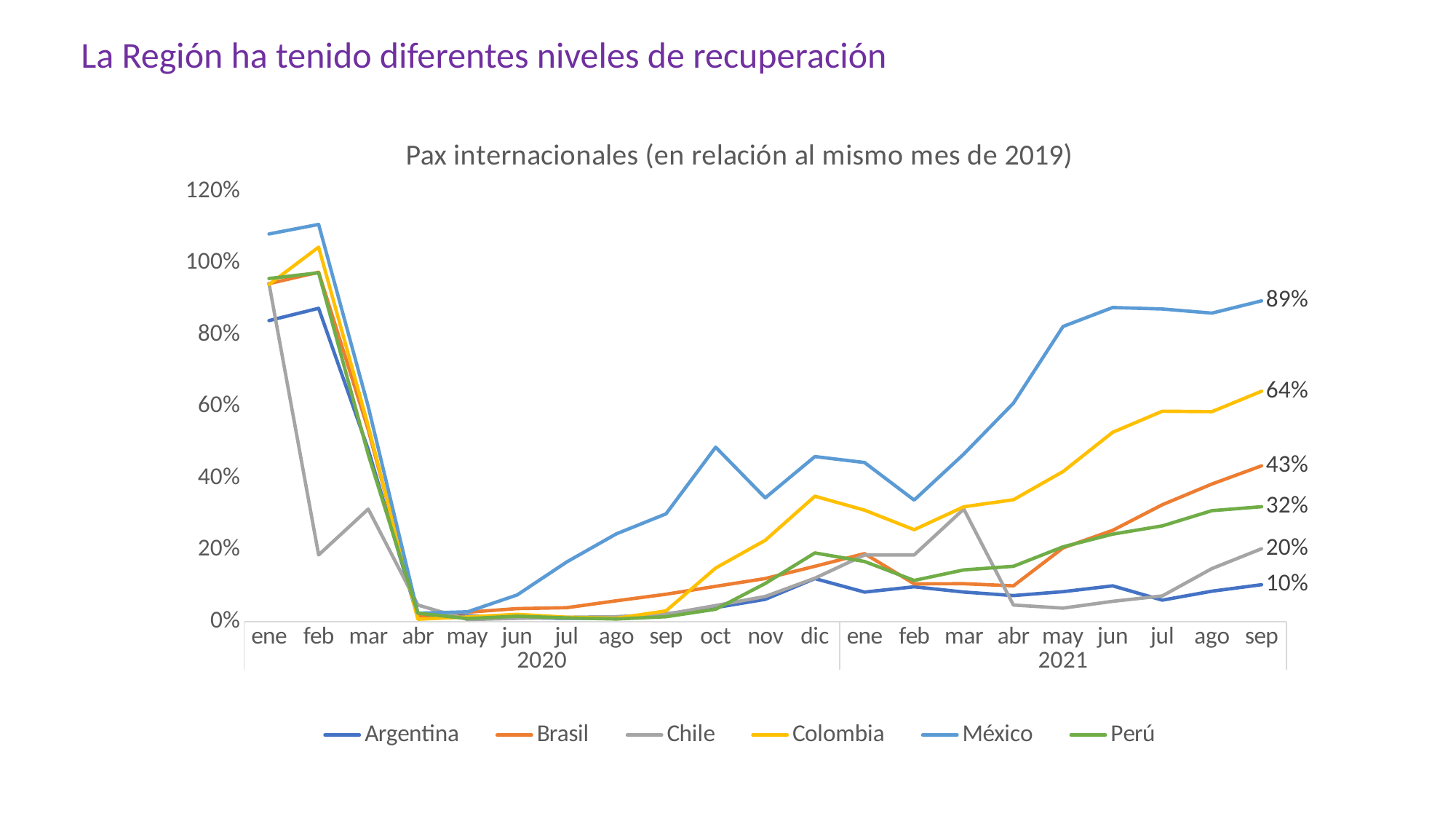
What is the value for Brasil in sep 2021? 43% How many series does the legend list? 6 What is the difference between México and Colombia in sep 2021? 25% What is the title of the chart? Pax internacionales (en relación al mismo mes de 2019) Which is larger in sep 2021, Perú or Chile? Perú What kind of chart is shown on the slide? line chart Is the value for México in feb 2020 greater or less than 100%? greater Which country has the lowest value in sep 2021? Argentina Which country has the highest value in sep 2021? México What is the value for México in sep 2021? 89% What is the value for Colombia in sep 2021? 64% What is the value for Argentina in sep 2021? 10%